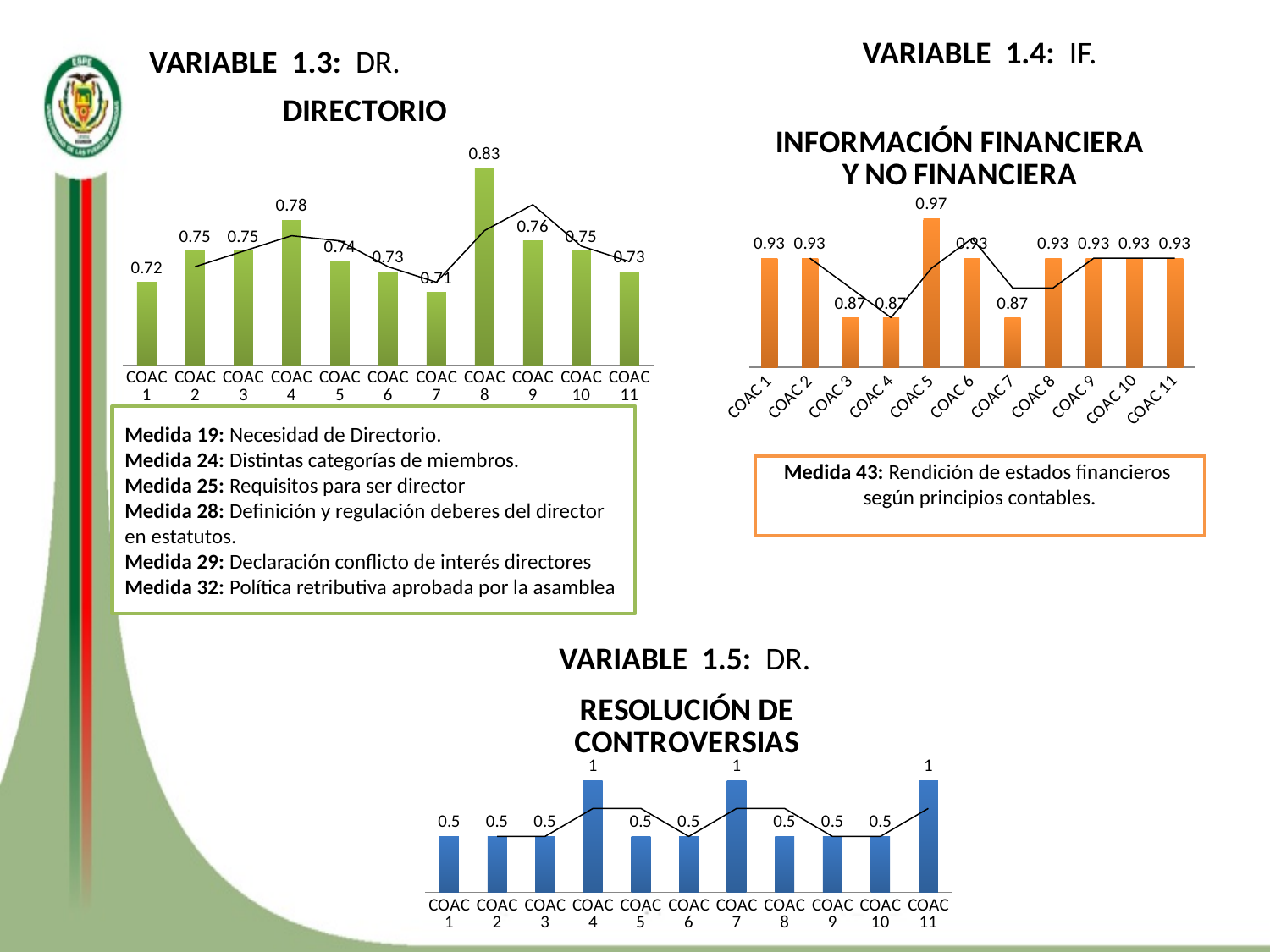
In the DIRECTORIO chart, which COAC has the lowest value? COAC 7 In the DIRECTORIO chart, what is the value for COAC 8? 0.83 In the RESOLUCIÓN DE CONTROVERSIAS chart, how many COACs have a value of 1? 3 In the INFORMACIÓN FINANCIERA Y NO FINANCIERA chart, what is the value for COAC 7? 0.87 In the RESOLUCIÓN DE CONTROVERSIAS chart, what is the value for COAC 4? 1 How many COAC categories are shown in the DIRECTORIO chart? 11 What kind of chart is the RESOLUCIÓN DE CONTROVERSIAS chart? Bar chart with a line overlay In the INFORMACIÓN FINANCIERA Y NO FINANCIERA chart, what is the value for COAC 5? 0.97 In the INFORMACIÓN FINANCIERA Y NO FINANCIERA chart, which COAC has the highest value? COAC 5 In the DIRECTORIO chart, which is larger, the value for COAC 4 or the value for COAC 9? COAC 4 In the INFORMACIÓN FINANCIERA Y NO FINANCIERA chart, what is the difference between the values for COAC 5 and COAC 3? 0.10 In the DIRECTORIO chart, what is the difference between the values for COAC 8 and COAC 7? 0.12